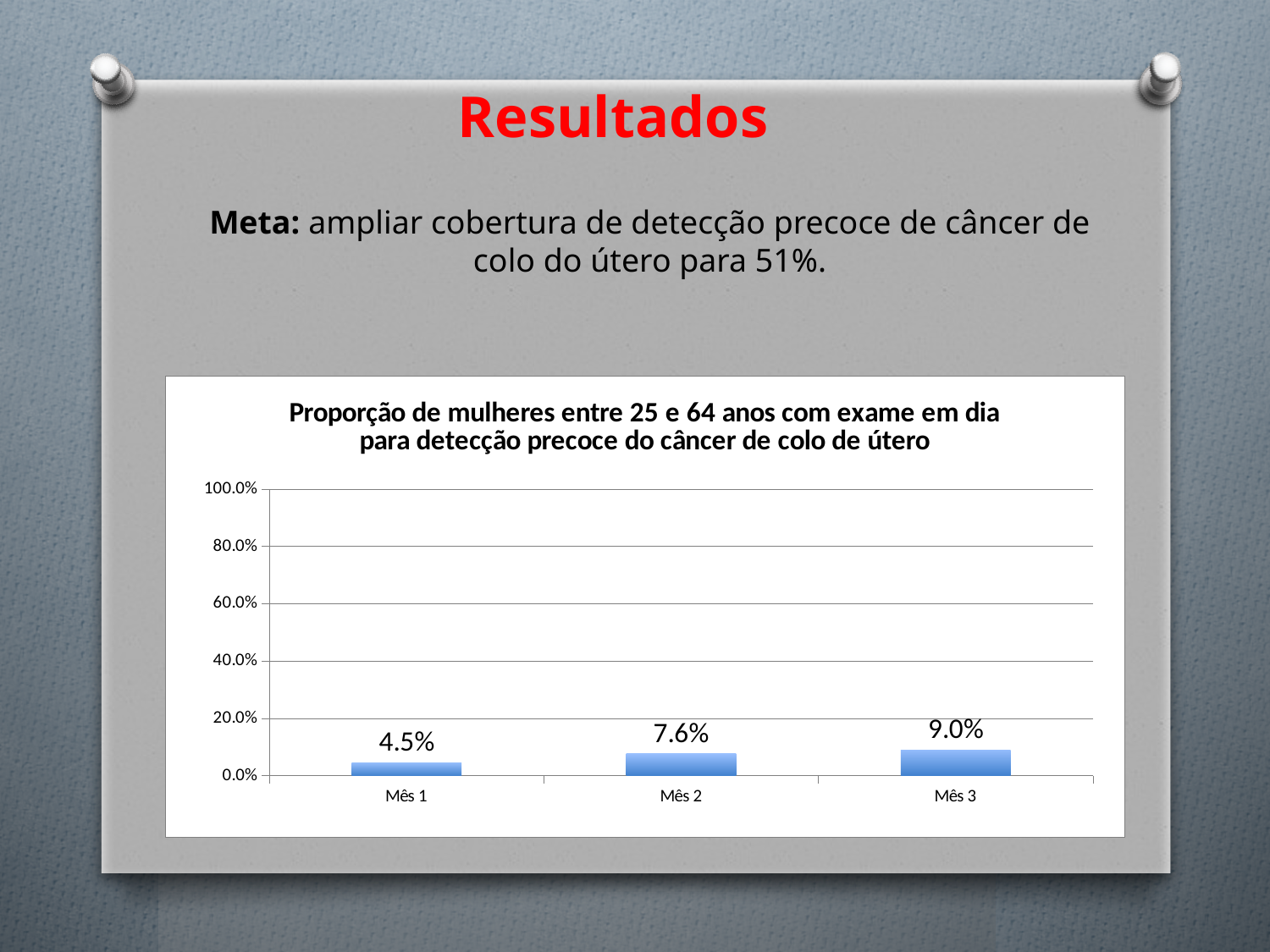
Do the values rise or fall from Mês 1 to Mês 3? Rise Is the value for Mês 3 greater or less than 20.0%? less What is the value for Mês 1? 4.5% What kind of chart is shown on the slide? Bar chart How many months are shown on the x axis? 3 Which month has the lowest value? Mês 1 What is the value for Mês 3? 9.0% What is the difference between the values for Mês 3 and Mês 1? 4.5% What is the difference between the values for Mês 2 and Mês 1? 3.1% Which is larger, the value for Mês 2 or the value for Mês 3? Mês 3 What is the value for Mês 2? 7.6% Which month has the highest value? Mês 3